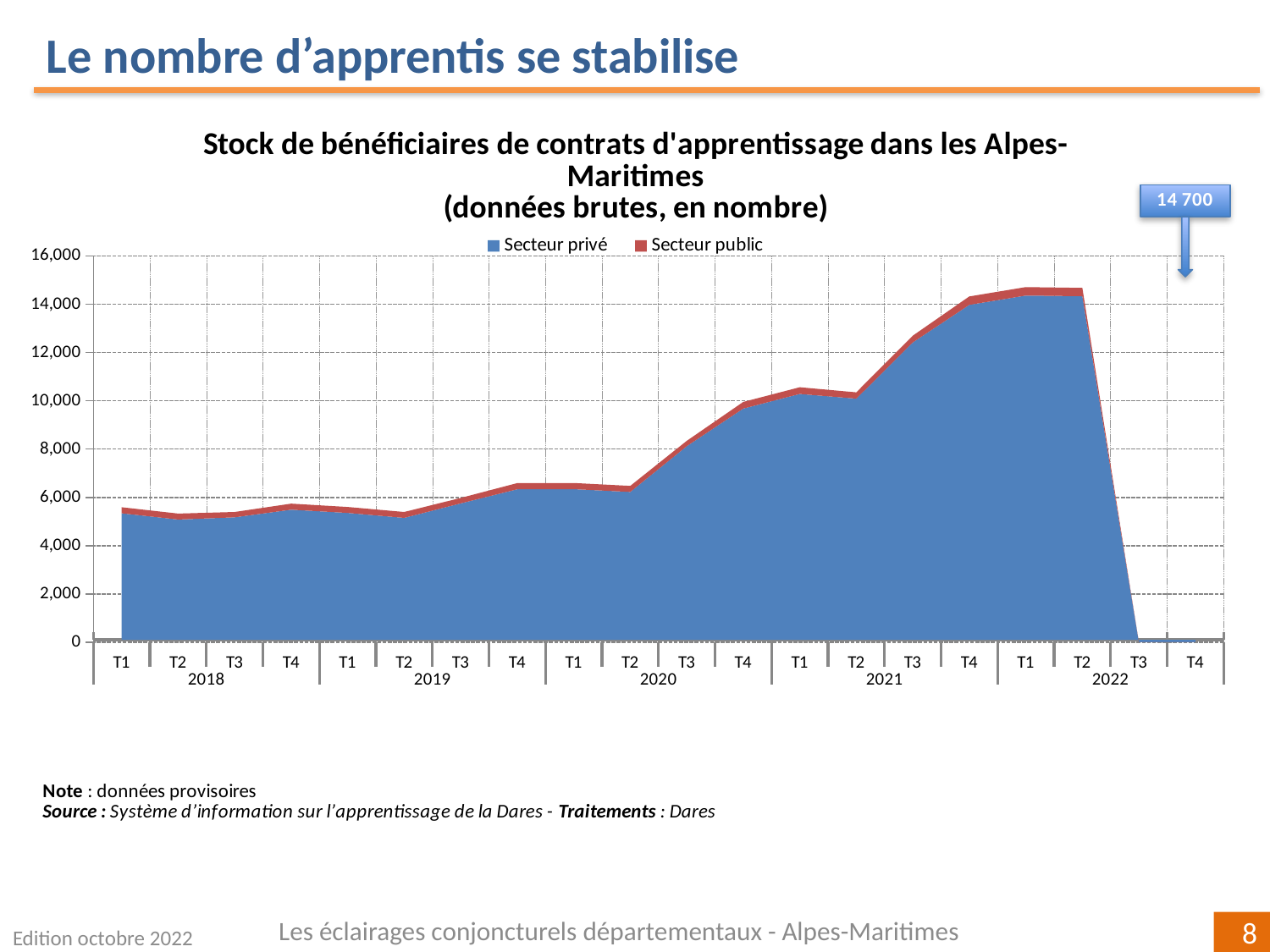
Is the total value for T1 2021 greater or less than 10,000? greater Is the total value for T2 2020 greater or less than 8,000? less Is the total value for T3 2020 greater or less than 8,000? greater Do the values rise or fall between T2 2020 and T1 2022? rise Which series is shown in blue? Secteur privé How many years are labelled along the x axis? 5 What are the two series named in the legend? Secteur privé and Secteur public What kind of chart is shown on the slide? Stacked area chart How many series does the legend list? 2